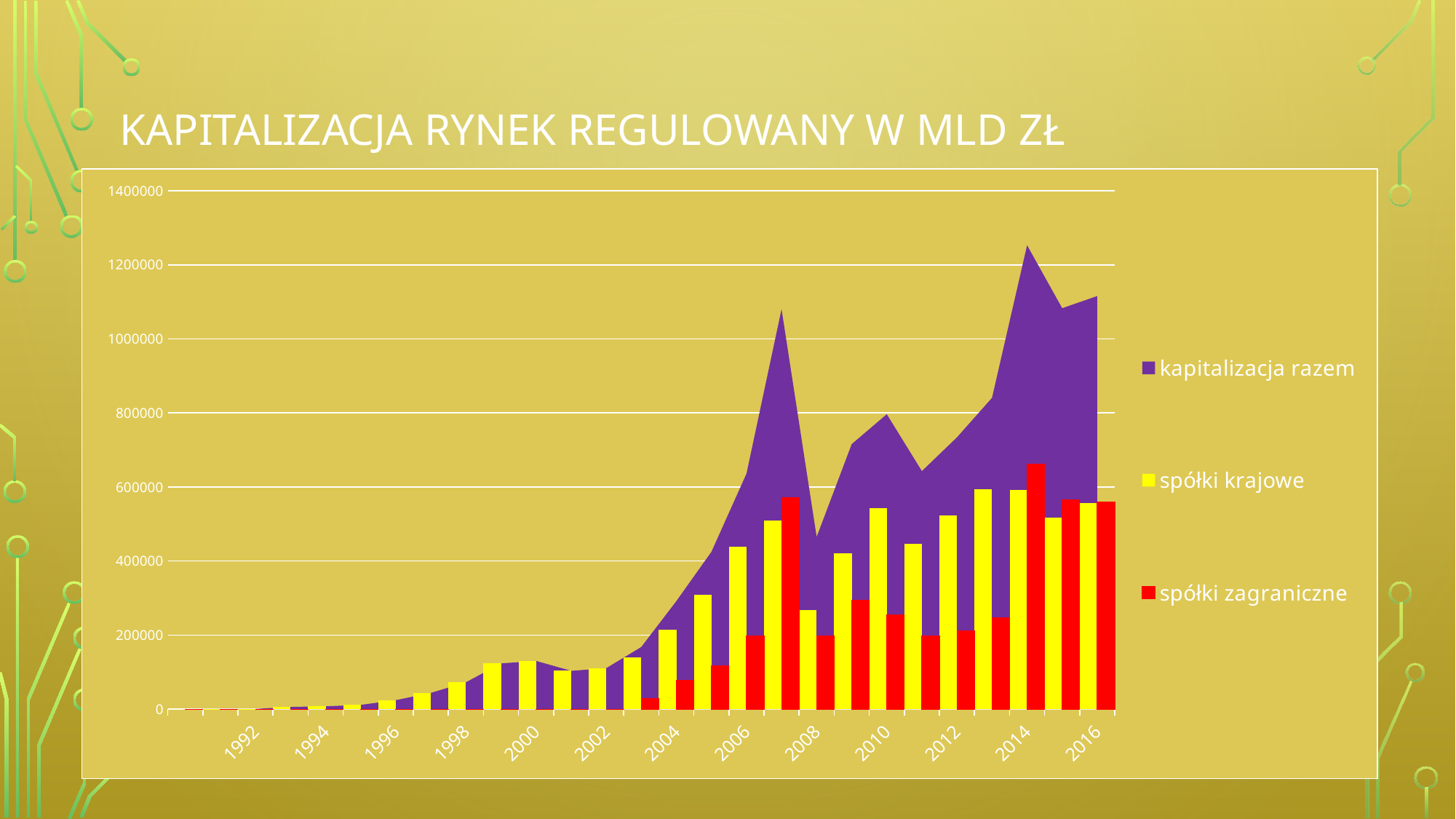
In which year does the kapitalizacja razem series reach its highest value? 2014 Which series is shown in red? spółki zagraniczne What is the title of the chart? KAPITALIZACJA RYNEK REGULOWANY W MLD ZŁ How many series does the legend list? 3 In which year is the spółki zagraniczne value highest? 2014 Is the spółki zagraniczne value for 2014 greater or less than 600000? greater Is the kapitalizacja razem value for 2007 greater or less than 1000000? greater Is the spółki zagraniczne value for 2008 greater or less than 400000? less Does the kapitalizacja razem series rise or fall from 1992 to 2007? rise In 2010, which is larger: spółki krajowe or spółki zagraniczne? spółki krajowe In 2007, which is larger: spółki krajowe or spółki zagraniczne? spółki zagraniczne